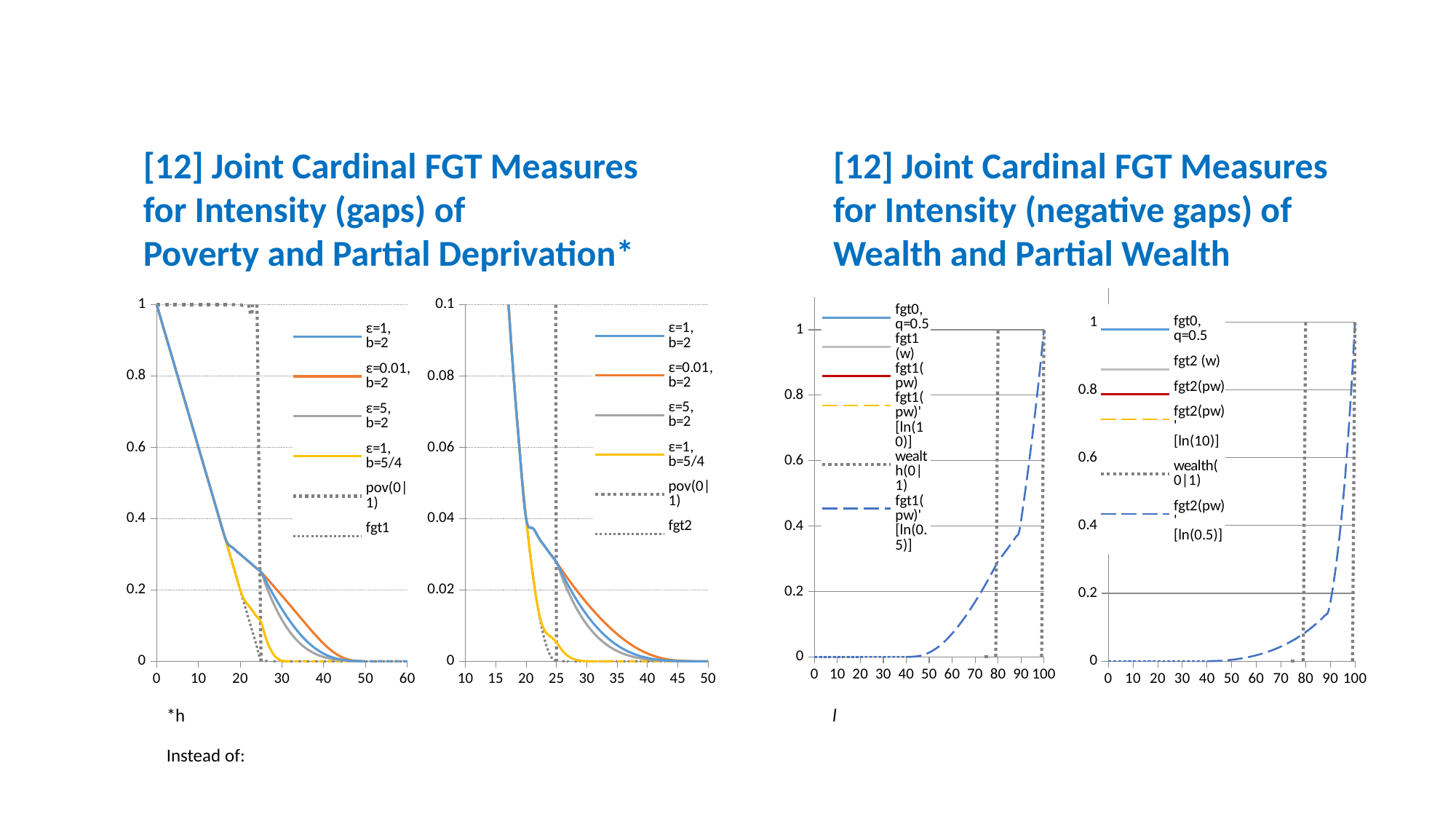
How many series does the legend of the rightmost chart list? 6 In the rightmost chart, is the value of the dashed fgt2(pw)' [ln(0.5)] series at x=90 greater or less than 0.2? less In the leftmost chart, is the value of the ε=1, b=2 series at x=10 greater or less than 0.4? greater How many series does the legend of the leftmost chart list? 6 In the leftmost chart, is the value of the ε=1, b=2 series at x=40 greater or less than 0.2? less In the third chart from the left, does the dashed fgt1(pw)' [ln(0.5)] series rise or fall as the x axis increases from 40 to 100? rise What kind of chart is the leftmost chart on the slide? line chart Which legend entry in the second chart from the left differs from the leftmost chart's legend, replacing fgt1? fgt2 In the leftmost chart, do the values of the ε=1, b=2 series rise or fall as the x axis increases? fall What is the maximum value shown on the y axis of the second chart from the left? 0.1 What kind of chart is the rightmost chart on the slide? line chart